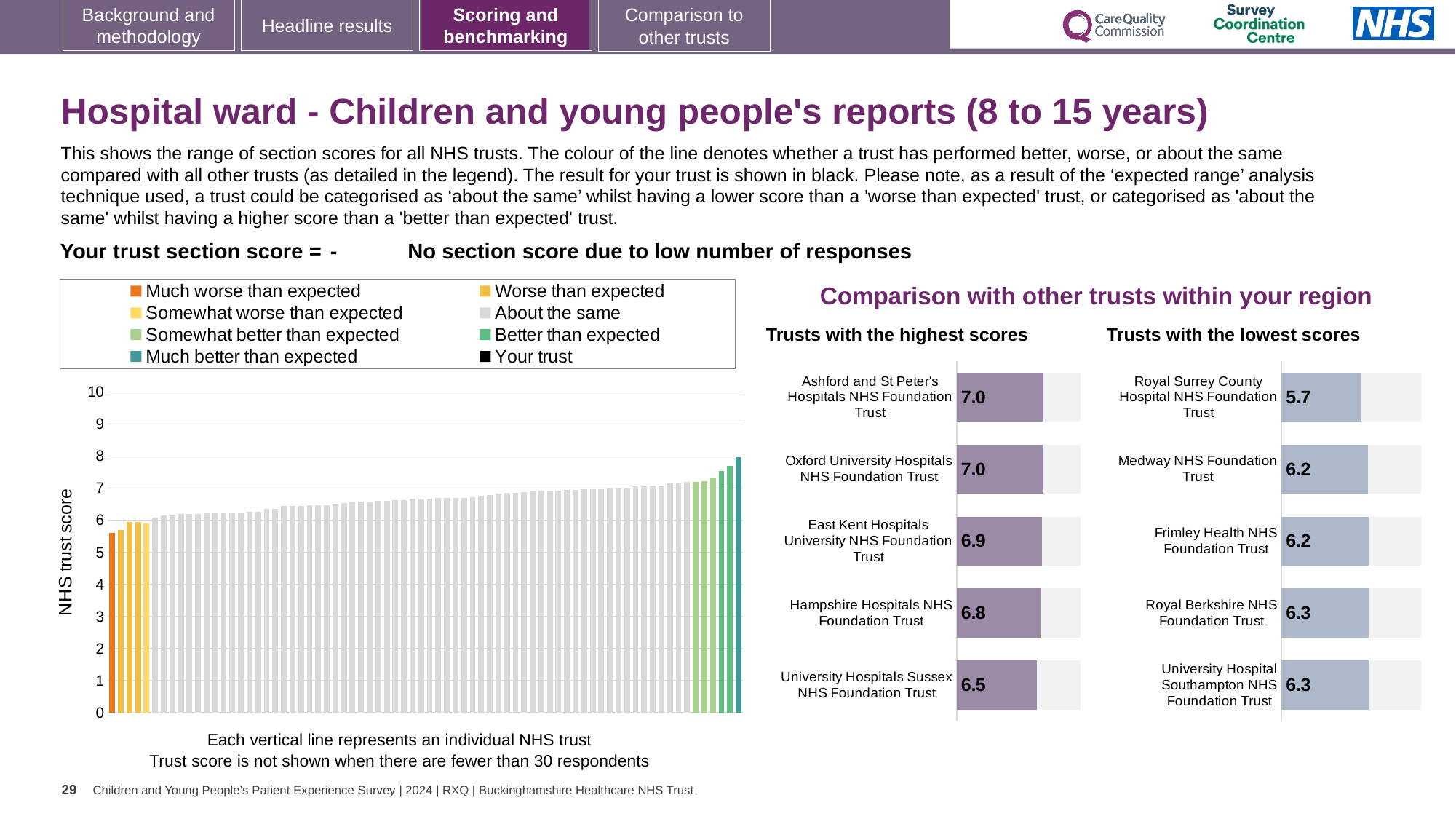
In the 'Trusts with the lowest scores' chart, what is the score for Medway NHS Foundation Trust? 6.2 In the 'Trusts with the highest scores' chart, what is the difference between the scores of Ashford and St Peter's Hospitals NHS Foundation Trust and University Hospitals Sussex NHS Foundation Trust? 0.5 In the 'Trusts with the lowest scores' chart, what is the difference between the scores of Royal Berkshire NHS Foundation Trust and Royal Surrey County Hospital NHS Foundation Trust? 0.6 In the large chart on the left showing NHS trust scores, do the bars rise or fall from left to right? Rise What kind of chart is the large chart on the left showing NHS trust scores? Bar chart In the 'Trusts with the lowest scores' chart, what is the score for Royal Surrey County Hospital NHS Foundation Trust? 5.7 In the large chart on the left showing NHS trust scores, is the value of the tallest bar greater or less than 7? greater In the 'Trusts with the lowest scores' chart, which trust has the lowest score? Royal Surrey County Hospital NHS Foundation Trust How many trusts are listed in the 'Trusts with the highest scores' chart? 5 In the 'Trusts with the highest scores' chart, what is the score for East Kent Hospitals University NHS Foundation Trust? 6.9 In the 'Trusts with the highest scores' chart, which has the higher score: Hampshire Hospitals NHS Foundation Trust or University Hospitals Sussex NHS Foundation Trust? Hampshire Hospitals NHS Foundation Trust In the 'Trusts with the highest scores' chart, what is the score for University Hospitals Sussex NHS Foundation Trust? 6.5